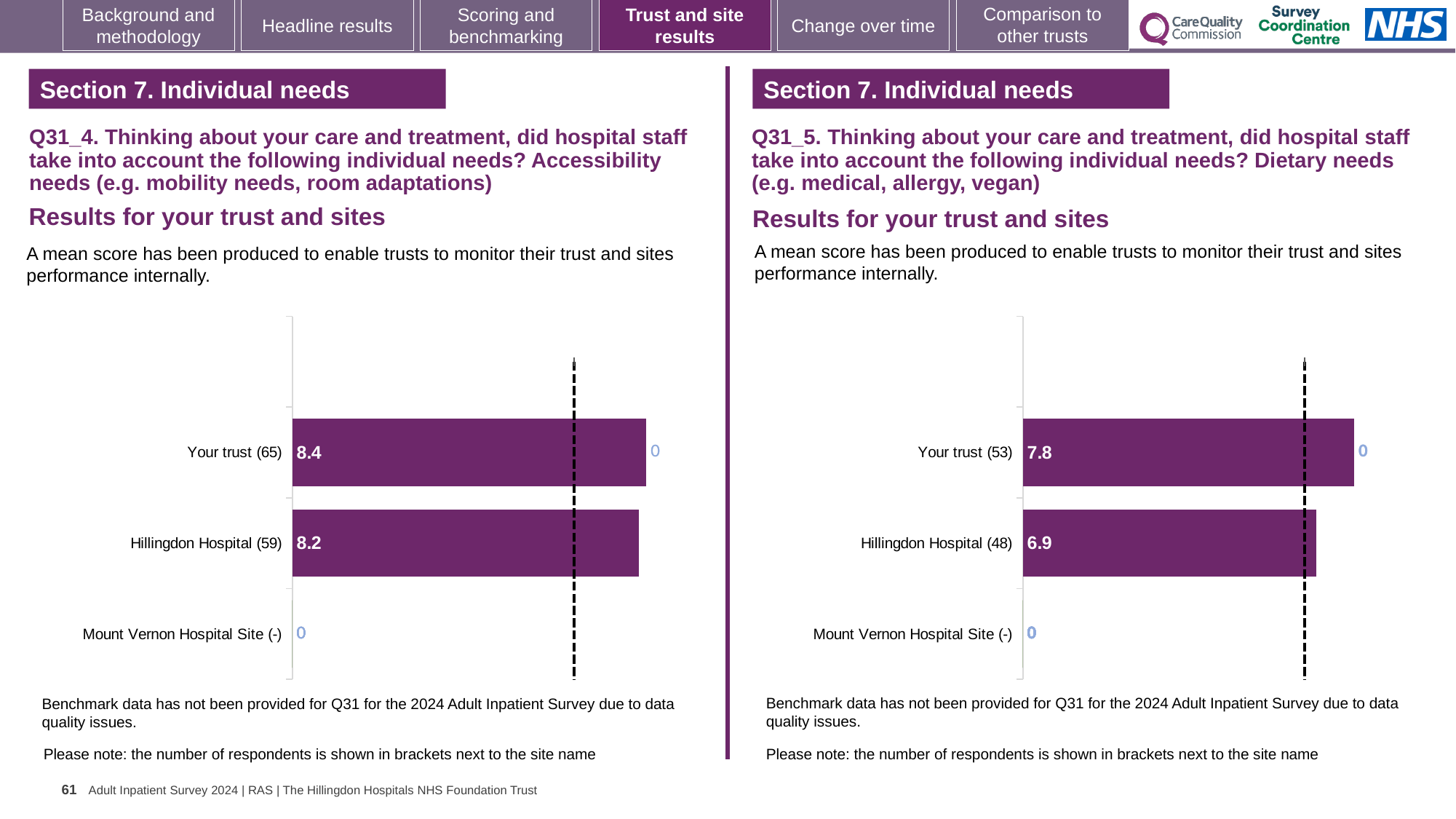
How many categories are listed on the y axis of the left chart (Q31_4)? 3 In the right chart (Q31_5, dietary needs), what is the difference between the scores for Your trust and Hillingdon Hospital? 0.9 What type of chart is used in the right chart (Q31_5, dietary needs)? Bar chart In the left chart (Q31_4, accessibility needs), how many respondents are shown for Your trust? 65 In the left chart (Q31_4, accessibility needs), which site has no bar plotted? Mount Vernon Hospital Site In the right chart (Q31_5, dietary needs), which is higher: Your trust or Hillingdon Hospital? Your trust In the left chart (Q31_4, accessibility needs), what is the mean score for Your trust? 8.4 In the right chart (Q31_5, dietary needs), how many respondents are shown for Hillingdon Hospital? 48 In the left chart (Q31_4, accessibility needs), what is the mean score for Hillingdon Hospital? 8.2 In the right chart (Q31_5, dietary needs), what is the mean score for Hillingdon Hospital? 6.9 In the right chart (Q31_5, dietary needs), what is the mean score for Your trust? 7.8 In the left chart (Q31_4, accessibility needs), what is the difference between the scores for Your trust and Hillingdon Hospital? 0.2